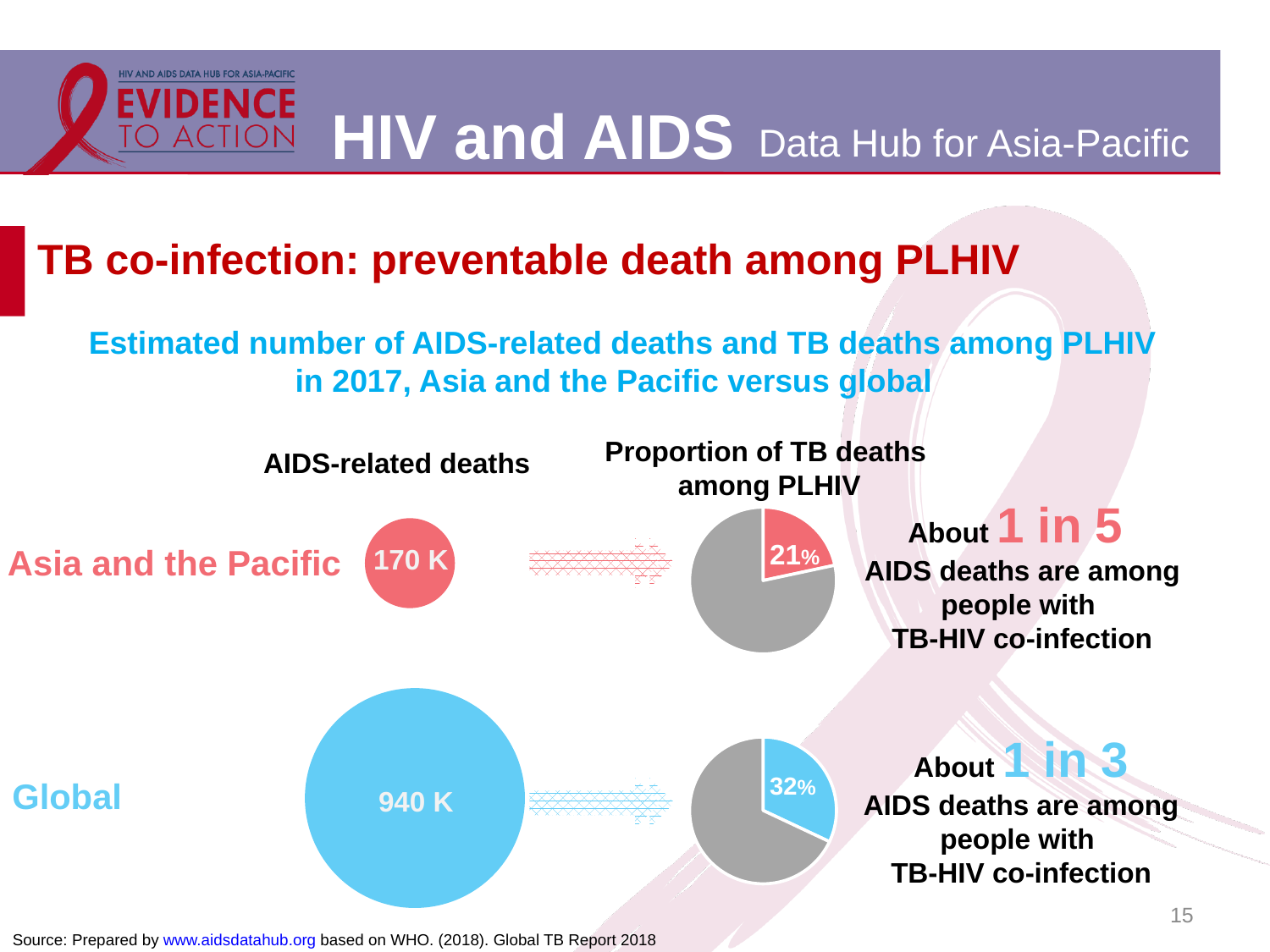
In the Proportion of TB deaths among PLHIV pie charts, what share of AIDS-related deaths in Asia and the Pacific are TB deaths? 21% In the Proportion of TB deaths among PLHIV pie charts, which region has the higher proportion of TB deaths, Asia and the Pacific or Global? Global What kind of chart is used to show the Proportion of TB deaths among PLHIV? Pie chart In the AIDS-related deaths chart, which has the larger number of AIDS-related deaths, Asia and the Pacific or Global? Global According to the slide, about how many AIDS deaths globally are among people with TB-HIV co-infection? About 1 in 3 In the Proportion of TB deaths among PLHIV pie chart for Asia and the Pacific, is the TB deaths share greater or less than 50%? less In the Proportion of TB deaths among PLHIV pie charts, what is the difference in percentage points between the Global and Asia and the Pacific proportions? 11 percentage points In the Proportion of TB deaths among PLHIV pie charts, what share of AIDS-related deaths globally are TB deaths? 32% According to the slide, about how many AIDS deaths in Asia and the Pacific are among people with TB-HIV co-infection? About 1 in 5 How many regions are compared on the slide? 2 In the AIDS-related deaths chart, what is the estimated number of AIDS-related deaths globally? 940 K In the AIDS-related deaths chart, what is the estimated number of AIDS-related deaths for Asia and the Pacific? 170 K